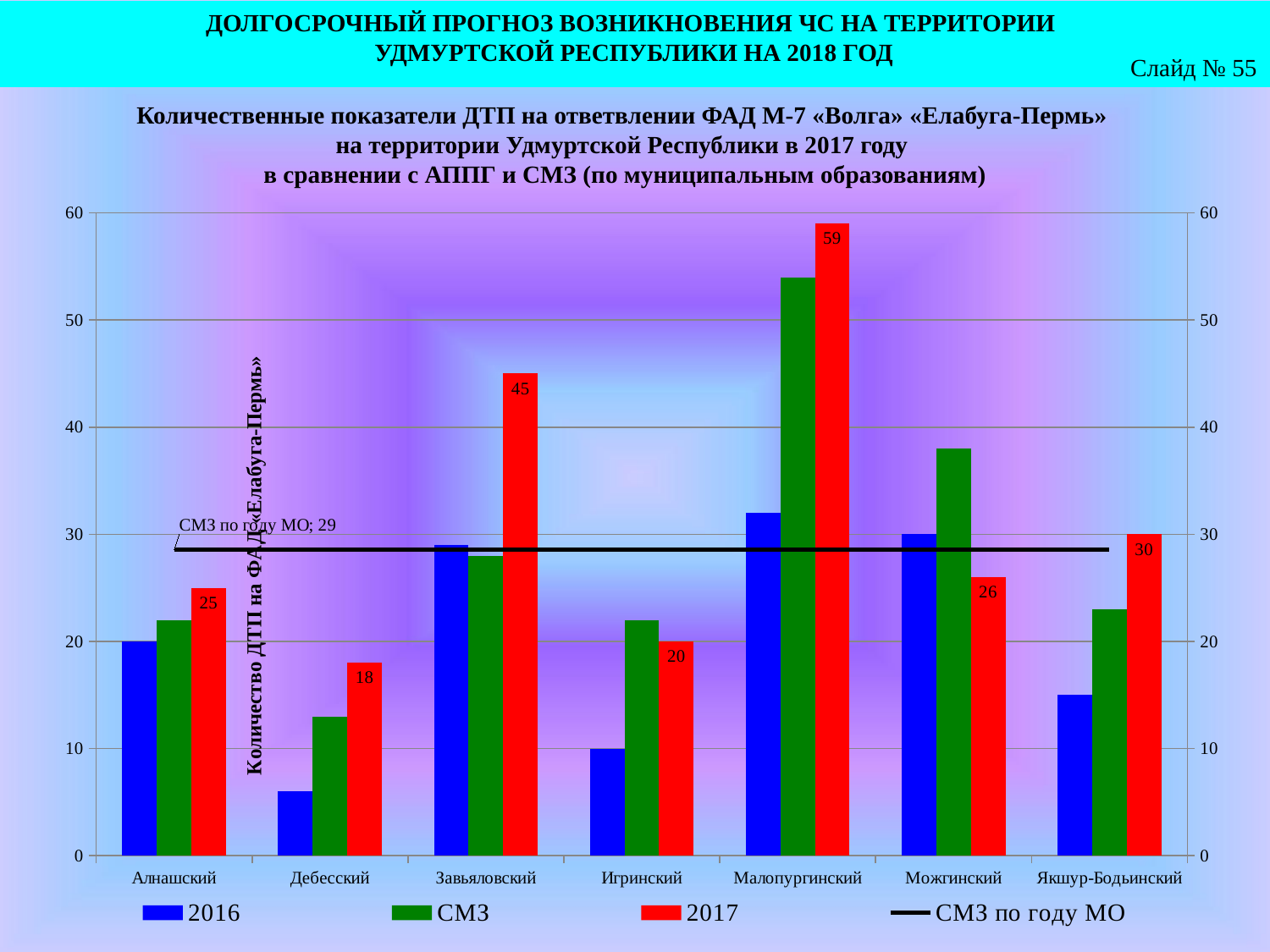
Which category has the lowest 2017 value? Дебесский What kind of chart is this? combination bar and line chart Is the 2016 value for Дебесский greater or less than 10? less What is the 2017 value for Завьяловский? 45 How many series does the legend list? 4 Is the СМЗ value for Малопургинский greater or less than 50? greater Which is larger, the 2017 value for Можгинский or for Алнашский? Можгинский What is the 2017 value for Малопургинский? 59 What value is labelled for the line СМЗ по году МО? 29 Which category has the highest 2017 value? Малопургинский How many municipal categories are shown on the x axis? 7 What is the difference between the 2017 values for Малопургинский and Завьяловский? 14